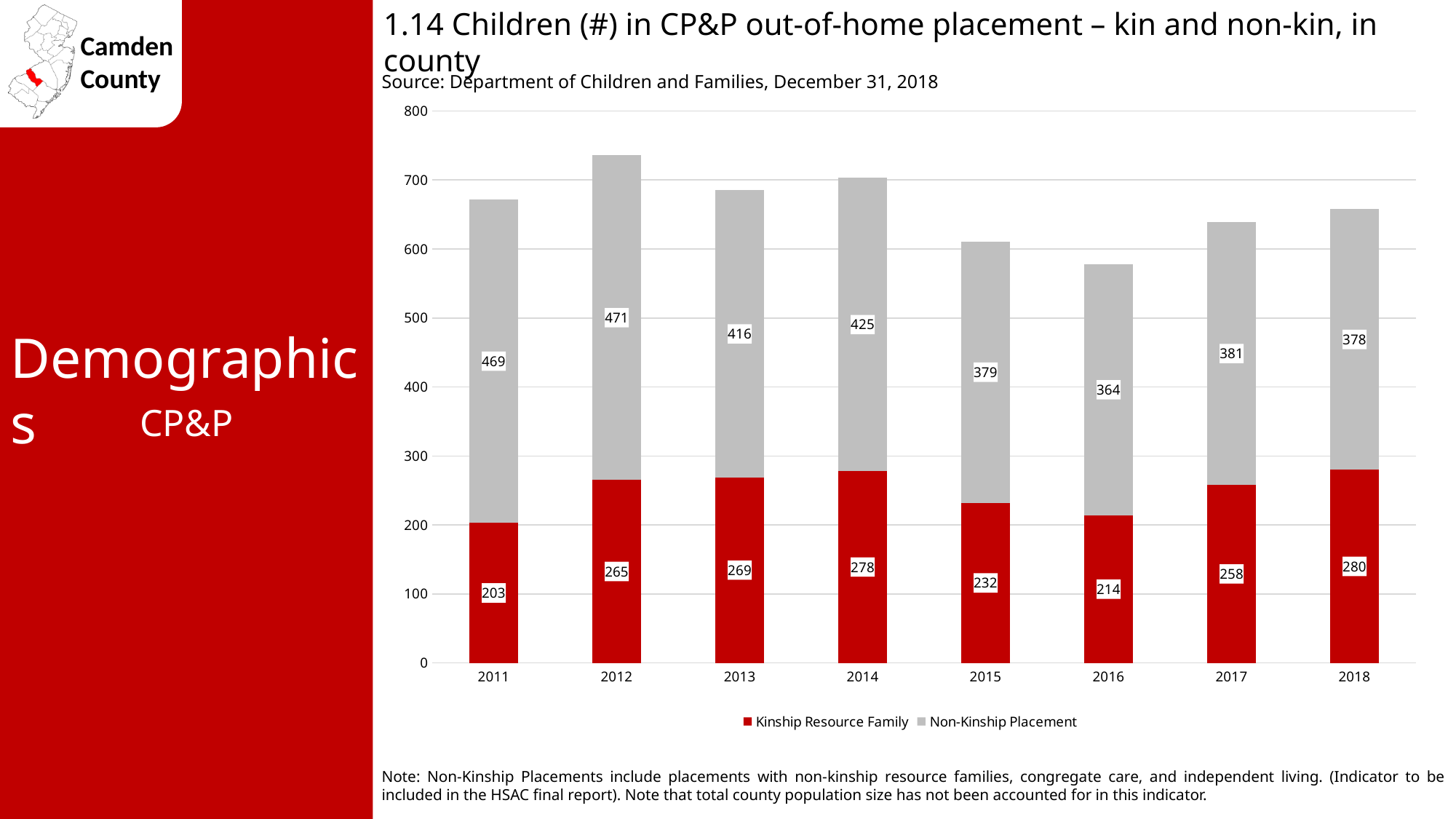
How many series does the legend list? 2 What is the Non-Kinship Placement value for 2016? 364 Which colour represents Kinship Resource Family in the chart? Red How many years are shown on the x axis? 8 Is the total height of the stacked bar for 2016 greater or less than 600? less What kind of chart is shown on the slide? Stacked bar chart What is the total of the stacked bar for 2018? 658 Which year has the lowest Kinship Resource Family value? 2011 What is the Kinship Resource Family value for 2014? 278 Which is larger, the Kinship Resource Family value for 2015 or for 2017? 2017 What is the difference between the Non-Kinship Placement values for 2012 and 2018? 93 Which year has the highest Non-Kinship Placement value? 2012